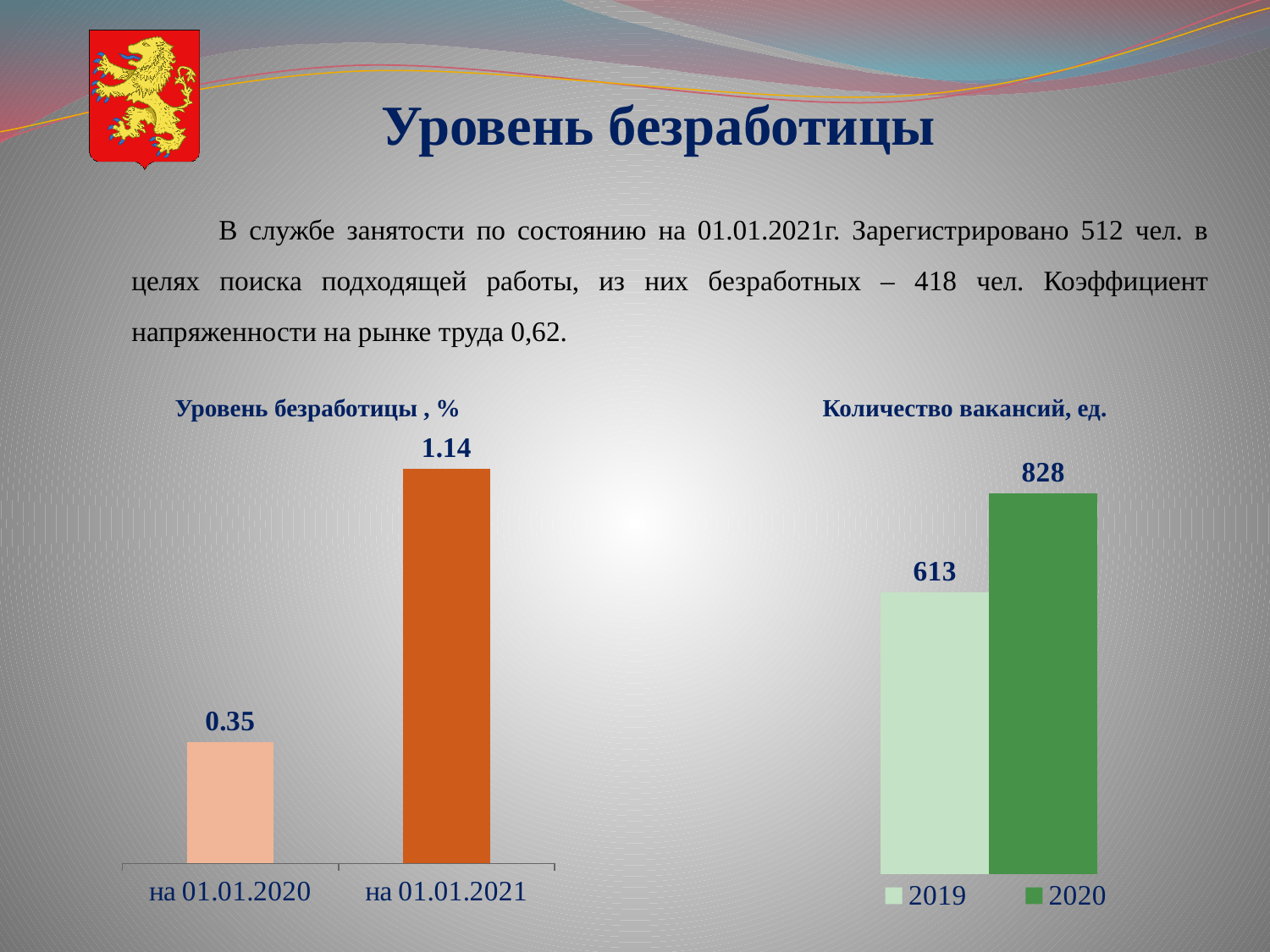
In the 'Количество вакансий, ед.' chart, what is the difference between the values for 2020 and 2019? 215 In the 'Уровень безработицы , %' chart, do the values rise or fall from left to right? rise In the 'Количество вакансий, ед.' chart, which year has the lowest value? 2019 In the 'Уровень безработицы , %' chart, what is the difference between the values for на 01.01.2021 and на 01.01.2020? 0.79 What type of chart is the 'Количество вакансий, ед.' chart? bar chart In the 'Уровень безработицы , %' chart, what is the value for на 01.01.2020? 0.35 In the 'Количество вакансий, ед.' chart, what is the value for 2020? 828 In the 'Количество вакансий, ед.' chart, how many entries does the legend list? 2 In the 'Уровень безработицы , %' chart, what is the value for на 01.01.2021? 1.14 In the 'Уровень безработицы , %' chart, which category has the highest value? на 01.01.2021 In the 'Уровень безработицы , %' chart, how many categories are shown? 2 In the 'Количество вакансий, ед.' chart, what is the value for 2019? 613